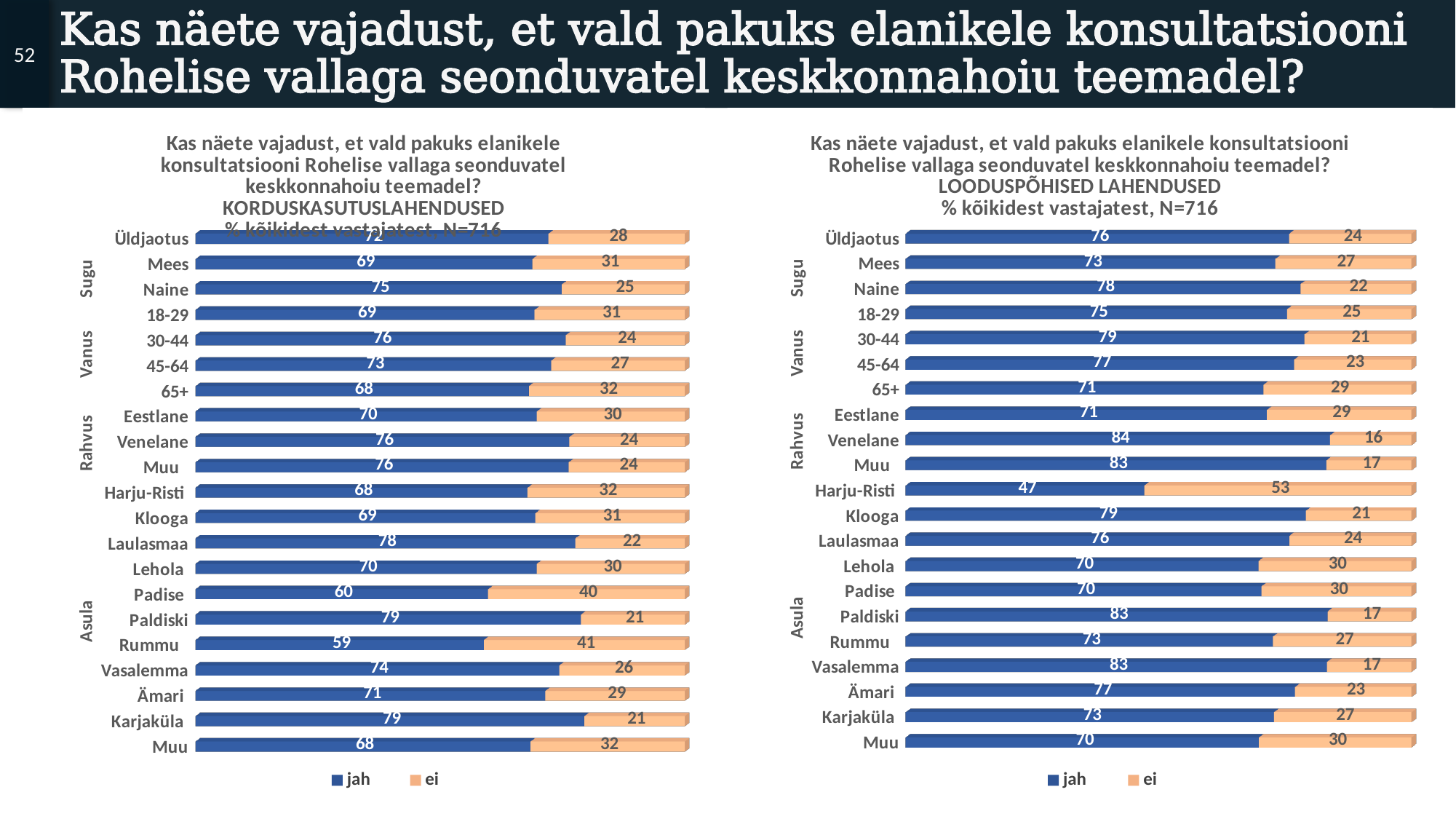
In the KORDUSKASUTUSLAHENDUSED chart, which category has the lowest 'jah' value? Rummu In the LOODUSPÕHISED LAHENDUSED chart, which is larger: the 'jah' value for Mees or for Naine? Naine What kind of chart is the LOODUSPÕHISED LAHENDUSED chart? Stacked bar chart How many series does the legend of the LOODUSPÕHISED LAHENDUSED chart list? 2 In the LOODUSPÕHISED LAHENDUSED chart, what is the 'jah' value for Venelane? 84 In the LOODUSPÕHISED LAHENDUSED chart, which category has the highest 'ei' value? Harju-Risti In the KORDUSKASUTUSLAHENDUSED chart, what is the 'jah' value for Padise? 60 How many categories are shown in the KORDUSKASUTUSLAHENDUSED chart? 21 In the LOODUSPÕHISED LAHENDUSED chart, what is the 'ei' value for Harju-Risti? 53 In the KORDUSKASUTUSLAHENDUSED chart, what is the difference between the 'jah' values for Paldiski and Rummu? 20 In the KORDUSKASUTUSLAHENDUSED chart, what colour represents the 'ei' series? Orange In the KORDUSKASUTUSLAHENDUSED chart, what is the total of the stacked bar for Laulasmaa? 100